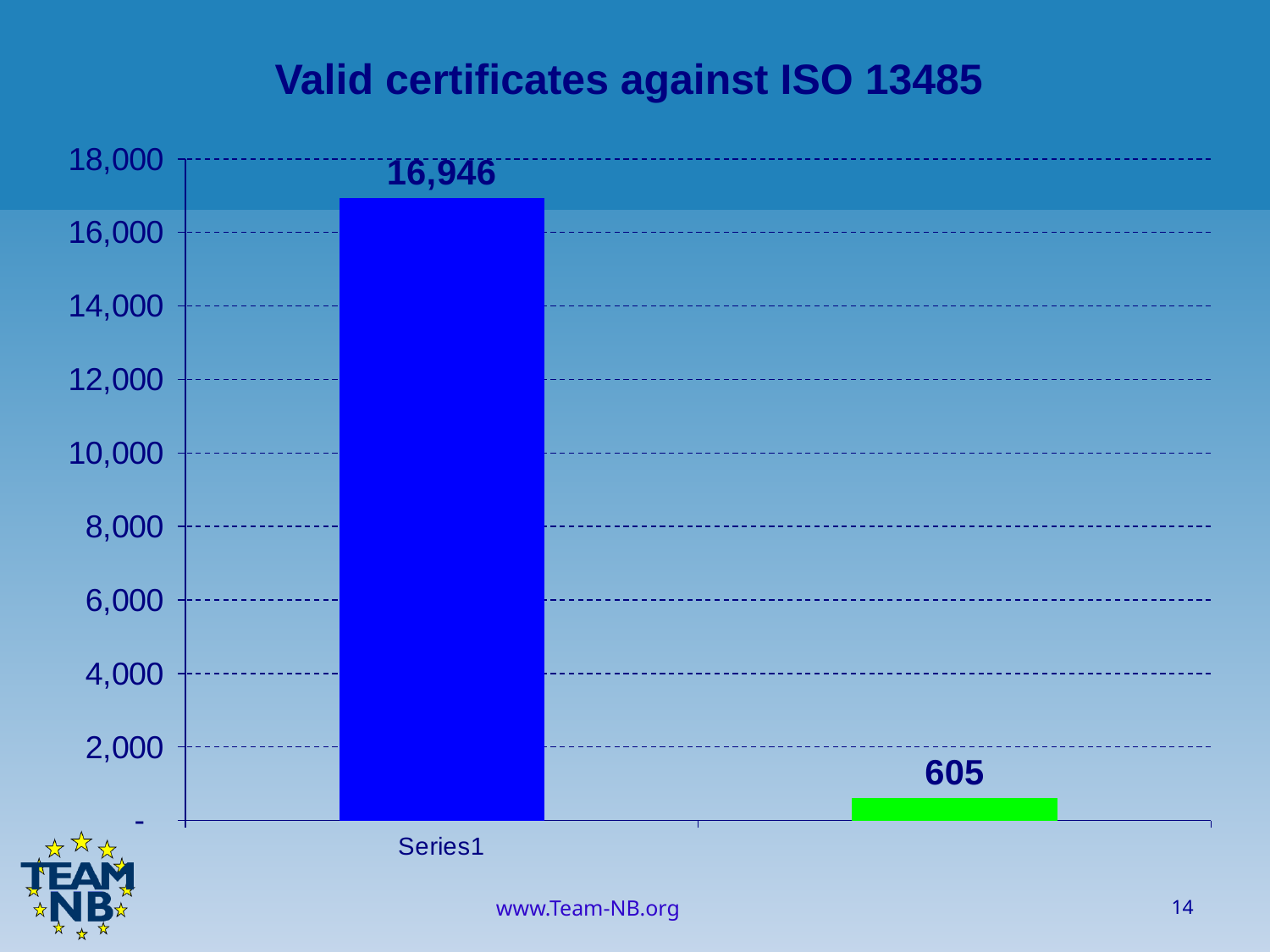
What kind of chart is shown on the slide? Bar chart Is the value of the green bar greater or less than 2,000? less Which bar is the shortest in the chart? The green bar Which bar is the tallest in the chart? The blue bar (Series1) What is the highest value shown on the vertical axis? 18,000 What value is shown on the blue bar labelled Series1? 16,946 How many bars are plotted in the chart? 2 What is the difference between the blue bar's value (16,946) and the green bar's value (605)? 16,341 Which is larger, the value of the blue bar or the value of the green bar? The blue bar What value is shown on the green bar on the right of the chart? 605 What is the title of the chart? Valid certificates against ISO 13485 Is the value of the blue bar greater or less than 16,000? greater